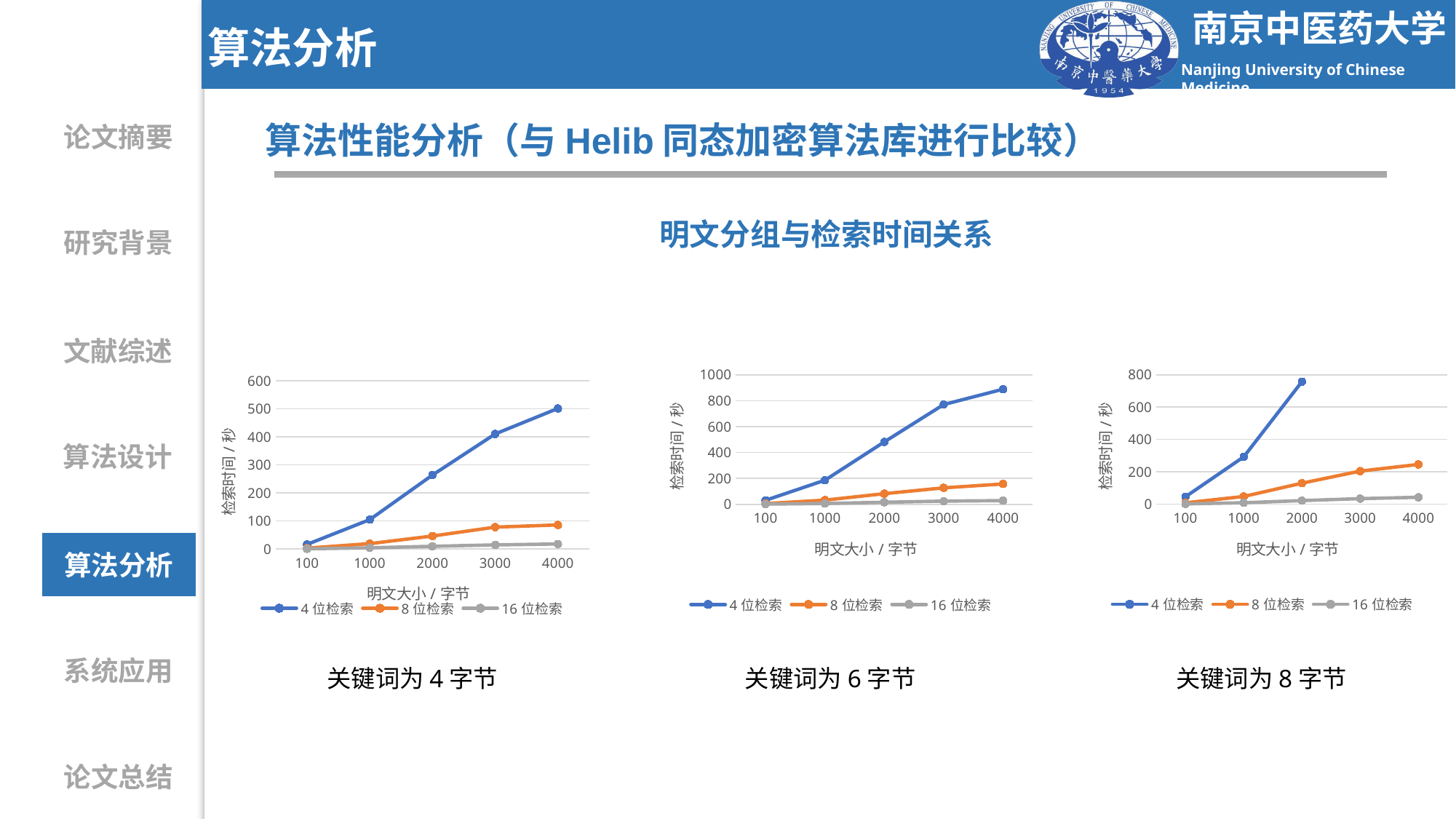
In the middle chart (关键词为6字节), is the value of 8位检索 at 4000 greater or less than 200? less In the middle chart (关键词为6字节), is the value of 4位检索 at 4000 greater or less than 800? greater How many series does the legend of the middle chart (关键词为6字节) list? 3 What kind of chart is the left chart (关键词为4字节)? line chart In the left chart (关键词为4字节), which series has the higher value at 4000: 4位检索 or 8位检索? 4位检索 In the left chart (关键词为4字节), is the value of 8位检索 at 4000 greater or less than 100? less In the right chart (关键词为8字节), does the 4位检索 series rise or fall as 明文大小 increases? rise How many x-axis points are plotted in the right chart (关键词为8字节)? 5 In the middle chart (关键词为6字节), which series has the lowest value at 4000? 16位检索